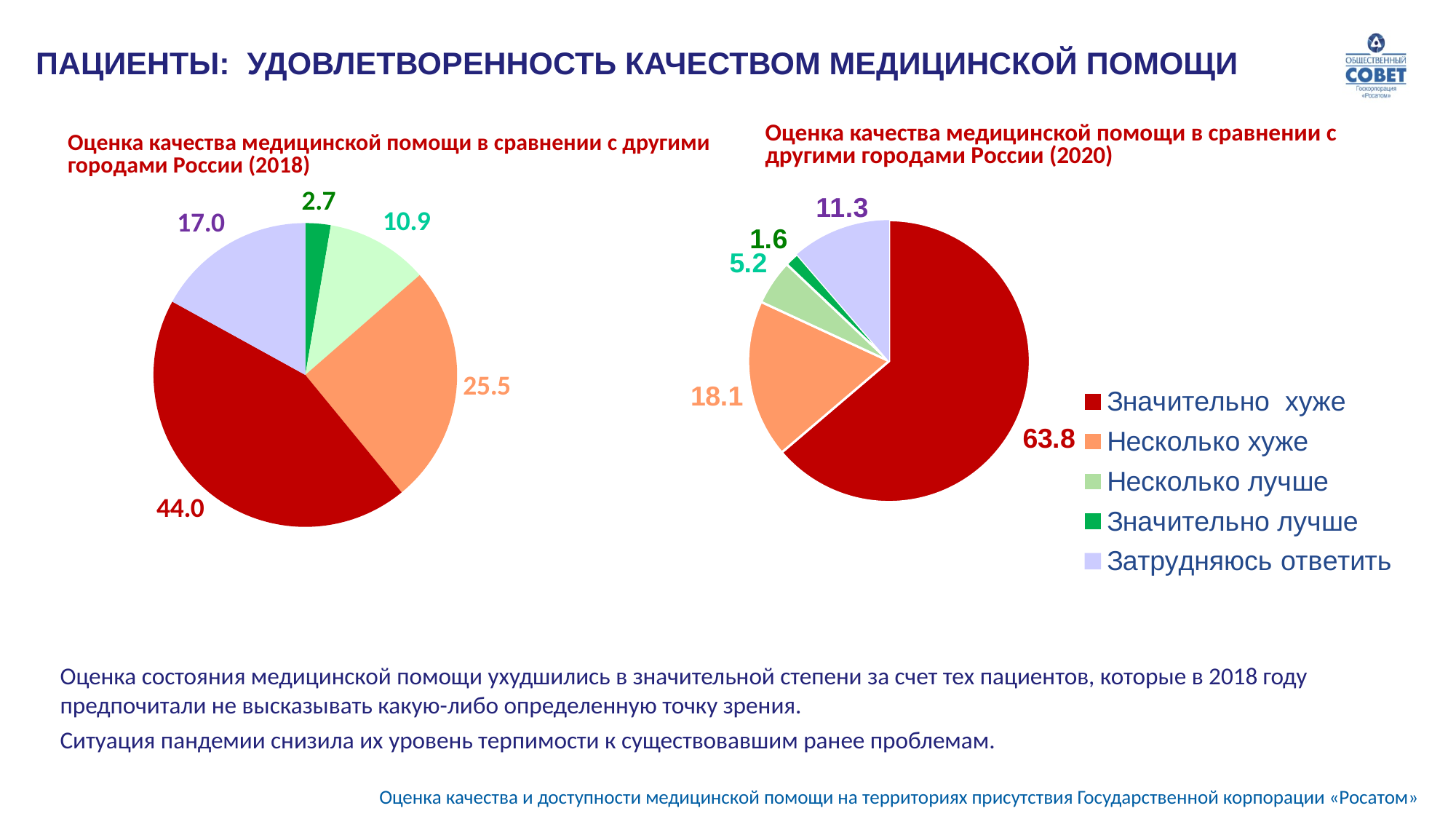
What type of chart is used on this slide? Pie chart What colour represents «Значительно хуже» in the legend? Dark red How many categories does the legend list? 5 In the 2018 pie chart (left), what is the value for «Затрудняюсь ответить»? 17.0 In the 2020 pie chart (right), what is the value for «Несколько хуже»? 18.1 In the 2018 pie chart (left), what is the difference between «Несколько хуже» and «Несколько лучше»? 14.6 In the 2018 pie chart (left), which category has the smallest slice? Значительно лучше In the 2020 pie chart (right), which category has the largest slice? Значительно хуже In the 2020 pie chart (right), which is larger: «Несколько лучше» or «Значительно лучше»? Несколько лучше In the 2018 pie chart (left), what is the value for «Значительно хуже»? 44.0 Which is larger: «Затрудняюсь ответить» in the 2018 chart or in the 2020 chart? 2018 What is the difference between the «Значительно хуже» value in the 2020 chart and in the 2018 chart? 19.8